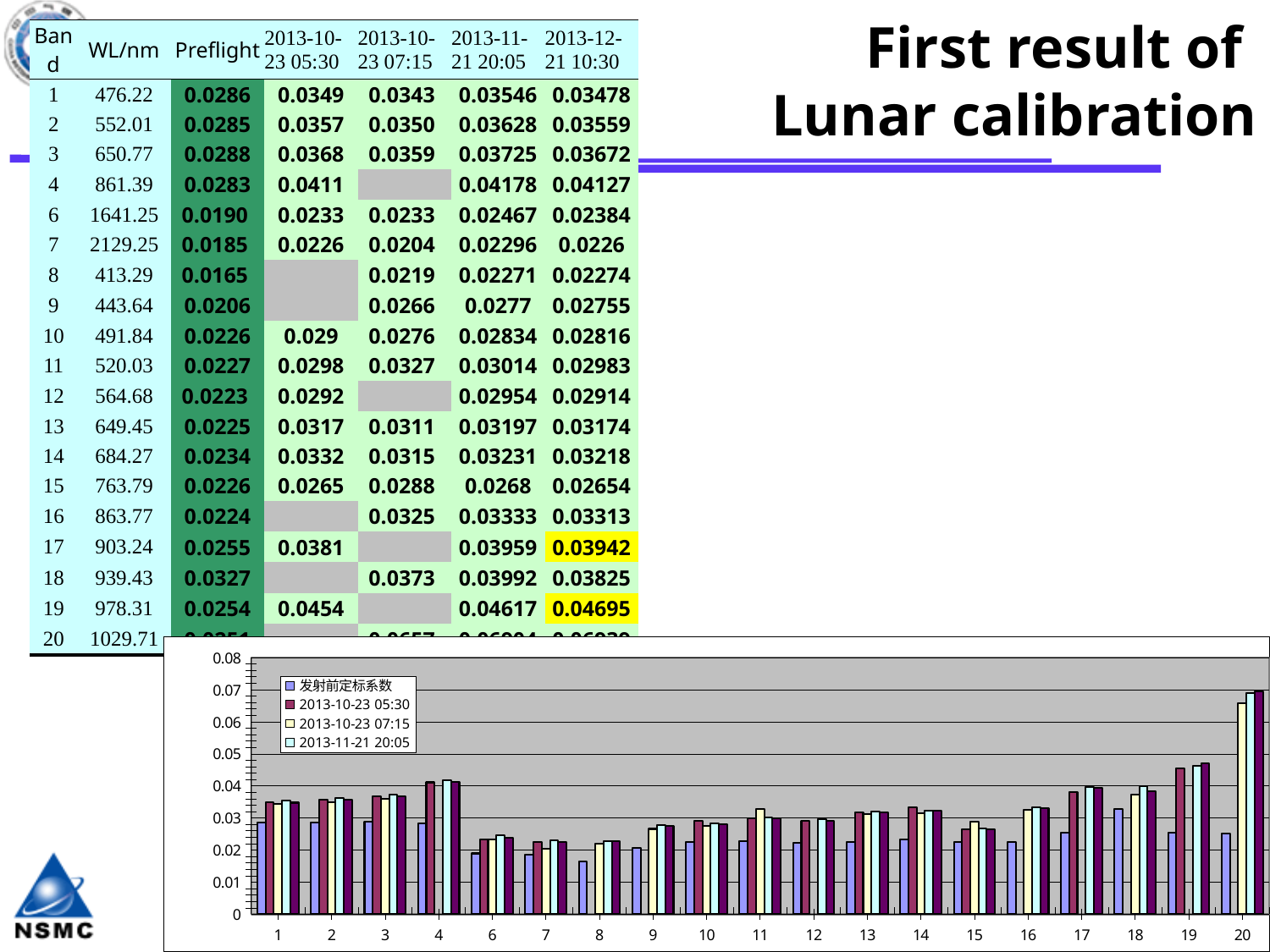
How many band categories are shown along the x axis of the chart? 19 What kind of chart is shown at the bottom of the slide? bar chart In the chart, which is larger for the 2013-11-21 20:05 series: band 20 or band 1? band 20 In the chart, is the 2013-11-21 20:05 value for band 20 greater or less than 0.06? greater What is the highest value shown on the chart's y axis? 0.08 In the chart, which is larger for the preflight (发射前定标系数) series: band 4 or band 6? band 4 How many series does the chart's legend list? 4 Which band has the highest bars in the chart? 20 In the chart, is the preflight (发射前定标系数) value for band 8 greater or less than 0.02? less What is the last series listed in the chart's legend? 2013-11-21 20:05 In the chart, is the 2013-10-23 05:30 value for band 19 greater or less than 0.04? greater